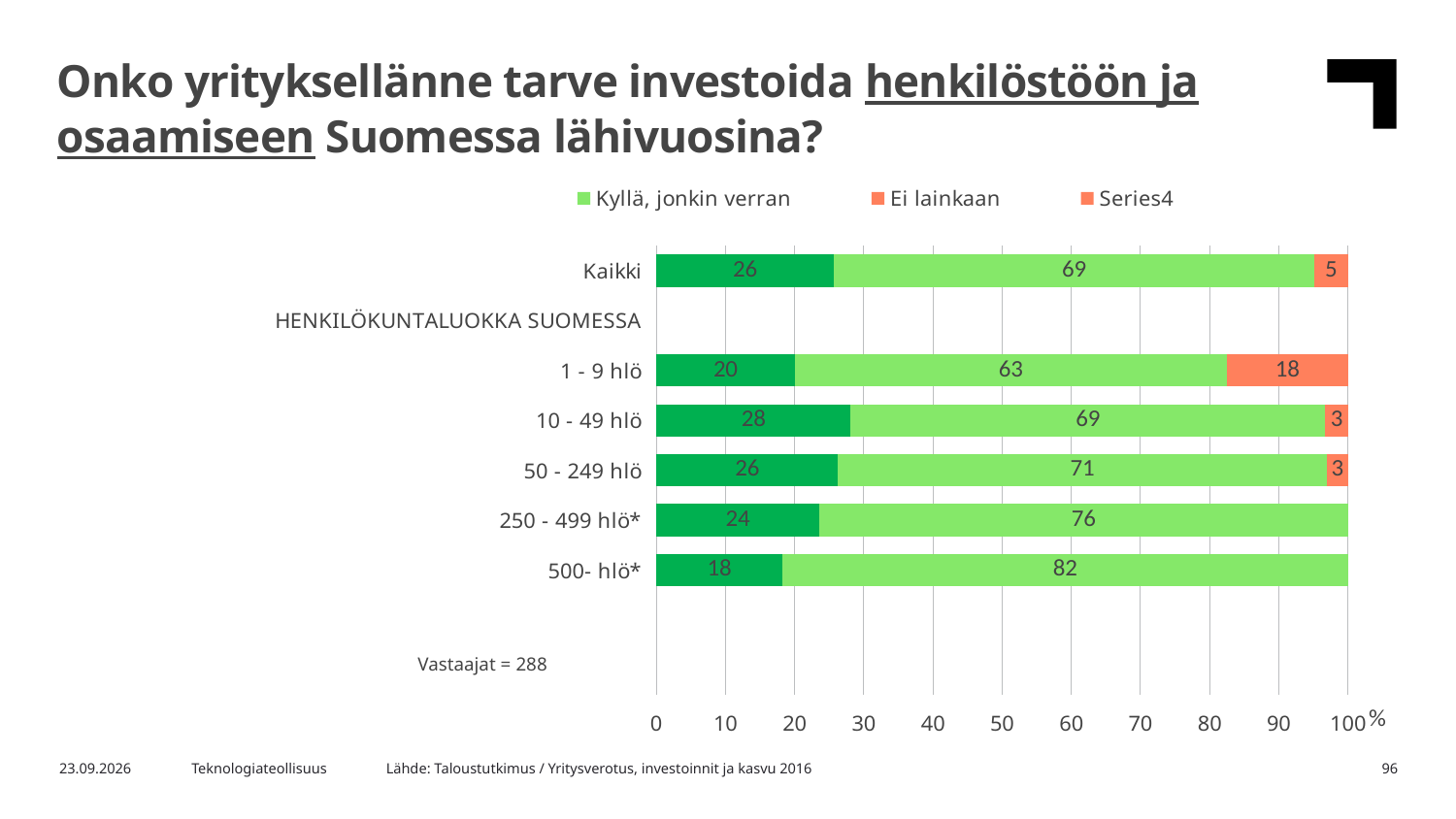
What is the value of the 'Ei lainkaan' segment for '1 - 9 hlö'? 18 What is the value of the 'Kyllä, jonkin verran' segment for '500- hlö*'? 82 What is the difference between the 'Kyllä, jonkin verran' values for '500- hlö*' and '1 - 9 hlö'? 19 Which category has the largest 'Kyllä, jonkin verran' segment? 500- hlö* What kind of chart is shown on the slide? Stacked bar chart Which category has the largest 'Ei lainkaan' segment? 1 - 9 hlö What is the value of the 'Kyllä, jonkin verran' segment for 'Kaikki'? 69 Is the 'Kyllä, jonkin verran' value larger for '250 - 499 hlö*' or for '50 - 249 hlö'? 250 - 499 hlö* How many series does the legend list? 3 What is the total of the stacked bar for 'Kaikki'? 100 Which category has the smallest dark green segment? 500- hlö* What is the value of the dark green segment for '10 - 49 hlö'? 28